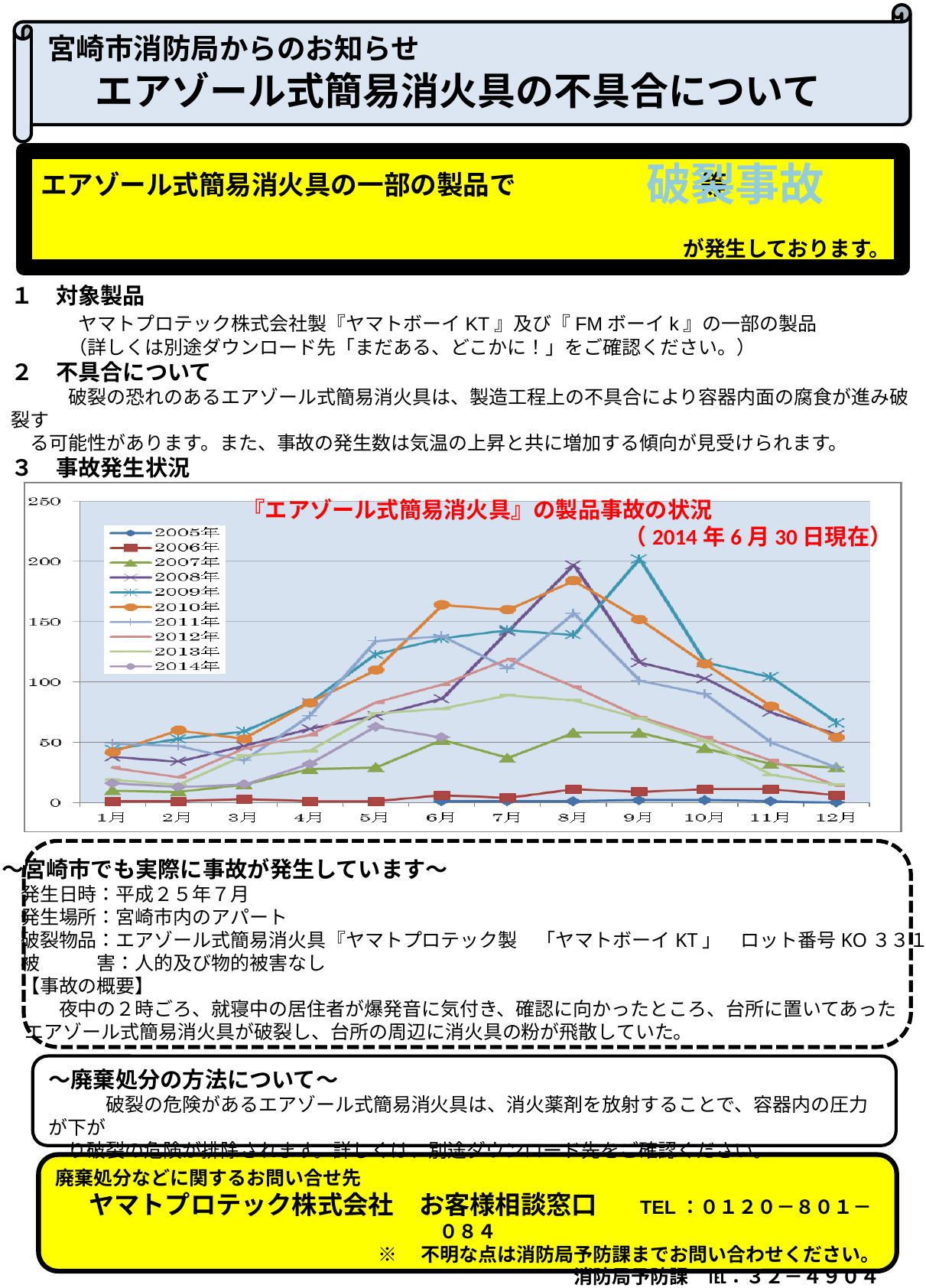
What kind of chart is shown on the slide? line chart Is the value for 2010年 in 6月 greater or less than 150? greater As of what date is the chart data current, according to the note on the chart? 2014年6月30日現在 In 9月, which is larger: the value for 2009年 or the value for 2010年? 2009年 How many months are shown along the x axis of the chart? 12 How many series does the chart legend list? 10 What is the title of the chart? 『エアゾール式簡易消火具』の製品事故の状況 In which month does the 2009年 series reach its highest value? 9月 Is the value for 2013年 in 7月 greater or less than 100? less In which month does the 2008年 series reach its highest value? 8月 Which series has the lowest values across the whole year? 2005年 Is the value for 2009年 in 9月 greater or less than 150? greater